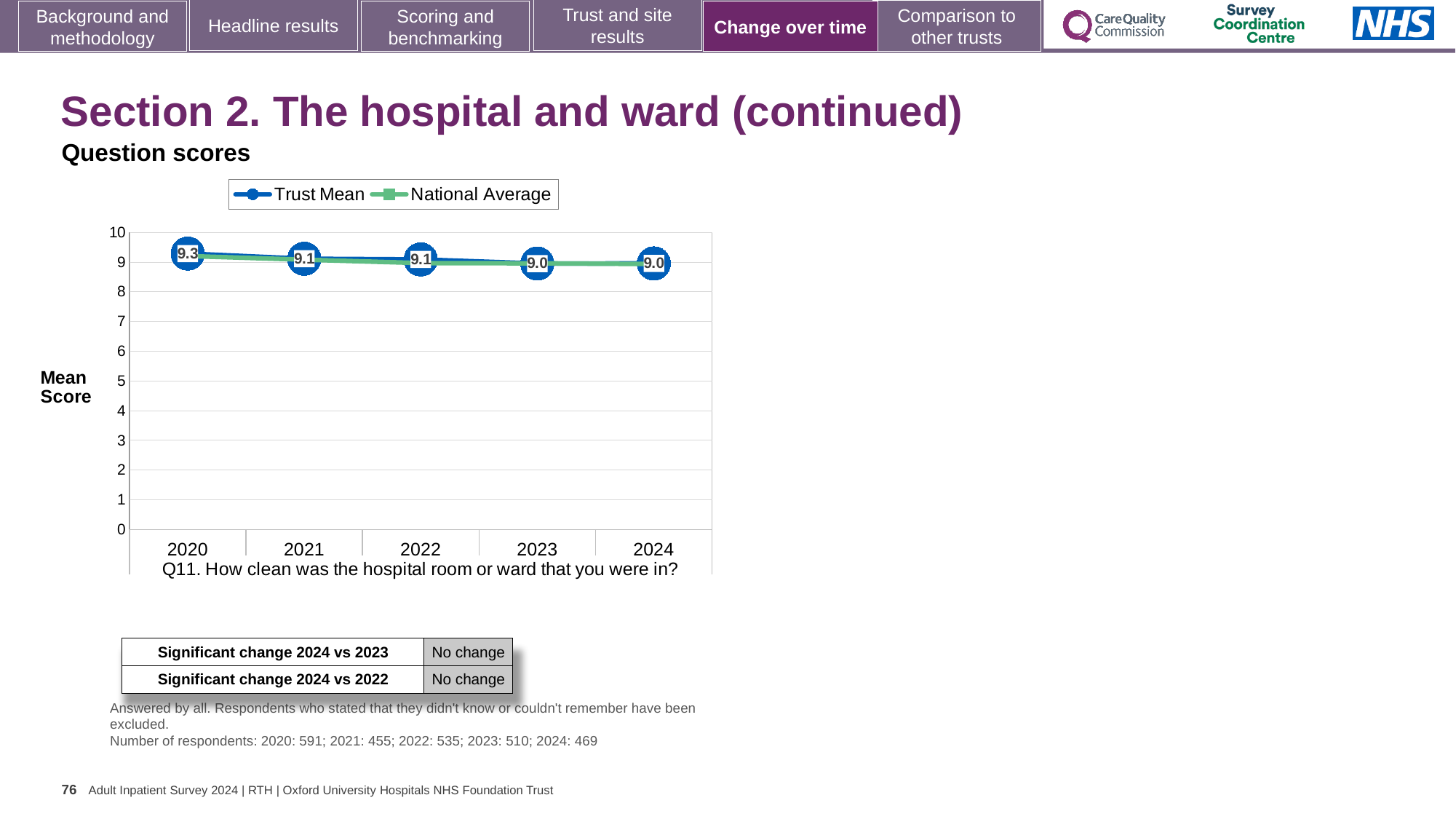
Does the Trust Mean rise or fall from 2020 to 2024? Fall How many years are shown on the x axis? 5 How many series does the legend list? 2 What is the label on the y axis? Mean Score In which year is the Trust Mean highest? 2020 Is the National Average value for 2020 greater or less than 8? greater What is the Trust Mean value for 2024? 9.0 What is the Trust Mean value for 2020? 9.3 Which is larger, the Trust Mean for 2020 or for 2023? 2020 What is the difference between the Trust Mean in 2020 and in 2024? 0.3 What kind of chart is shown? Line chart What is the Trust Mean value for 2022? 9.1